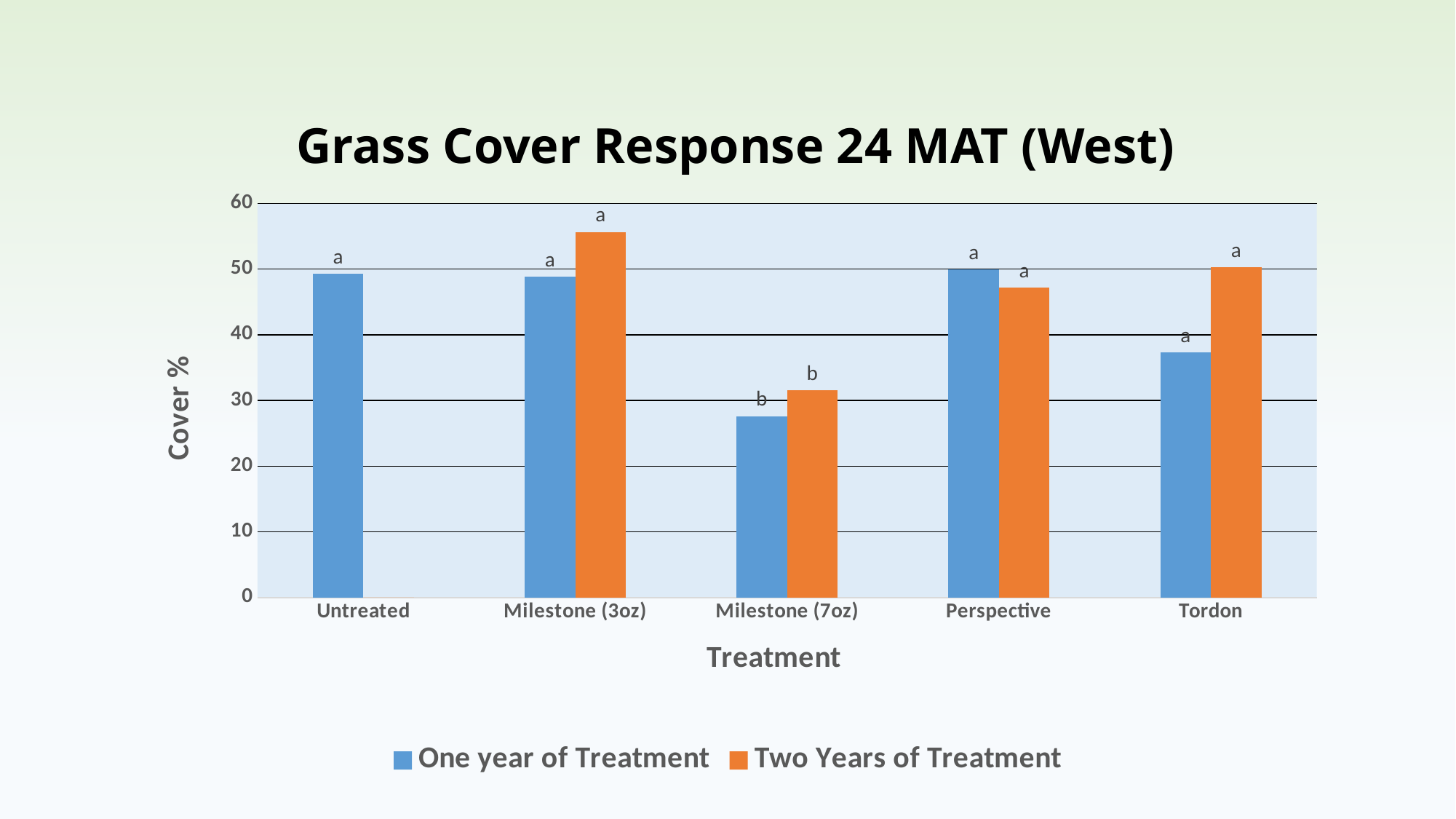
How many series does the legend list? 2 Is the One year of Treatment value for Tordon greater or less than 40? less How many treatment categories are shown on the x axis? 5 Is the Two Years of Treatment value for Milestone (3oz) greater or less than 50? greater For Tordon, which is larger: the One year of Treatment value or the Two Years of Treatment value? Two Years of Treatment What is the label on the y axis of the chart? Cover % For Perspective, which is larger: the One year of Treatment value or the Two Years of Treatment value? One year of Treatment Which treatment has the lowest One year of Treatment cover value? Milestone (7oz) Which treatment has the highest Two Years of Treatment cover value? Milestone (3oz) What type of chart is shown on the slide? Bar chart Is the One year of Treatment value for Milestone (7oz) greater or less than 30? less